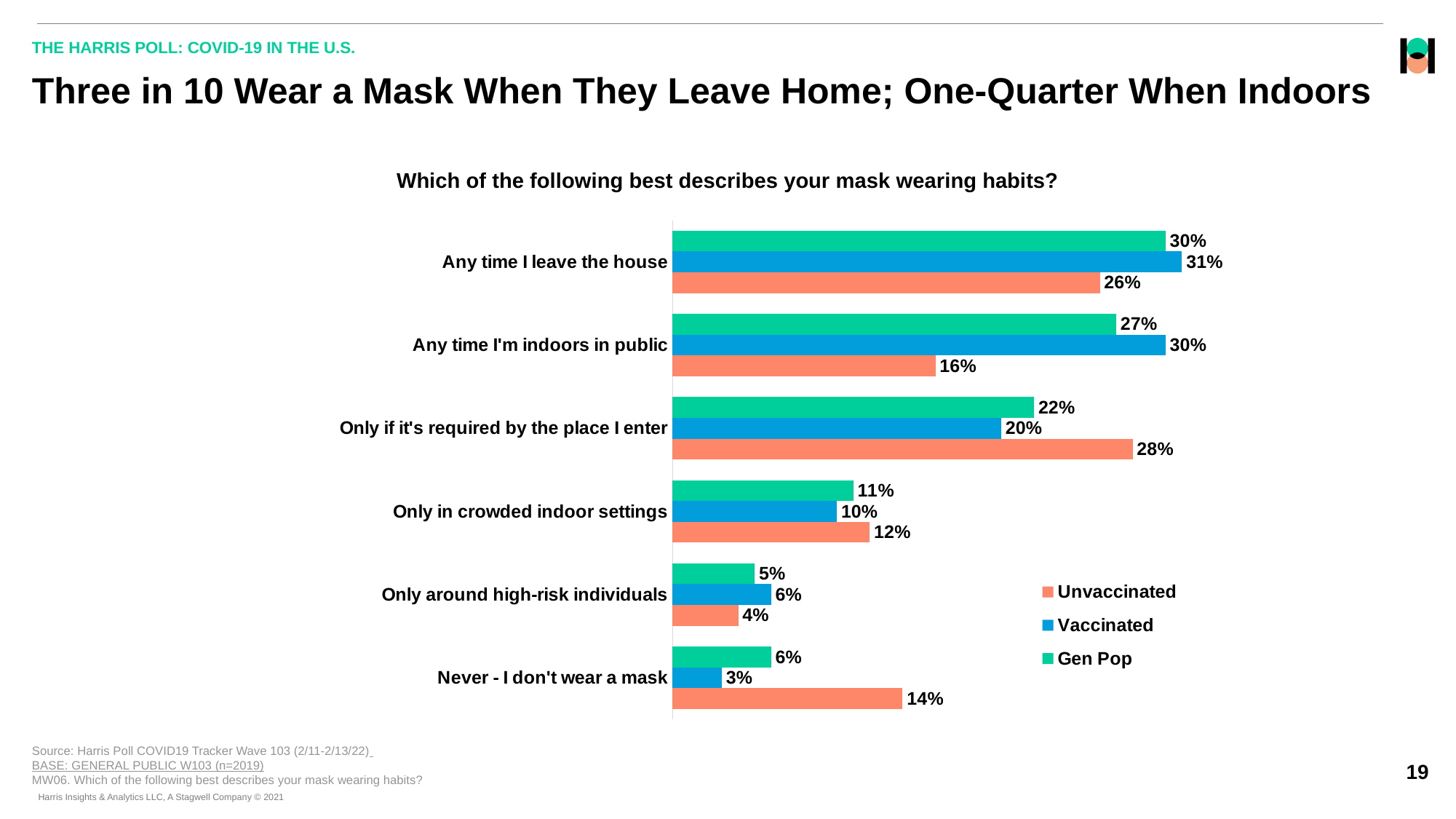
What type of chart is shown on the slide? Bar chart How many series does the legend list? 3 What is the difference between the Gen Pop and Unvaccinated values for 'Any time I'm indoors in public'? 11% What is the Vaccinated value for 'Never - I don't wear a mask'? 3% For 'Any time I'm indoors in public', which is larger: the Vaccinated value or the Unvaccinated value? Vaccinated What percentage of Gen Pop respondents say they wear a mask any time they leave the house? 30% How many response categories are shown on the chart? 6 Which category has the highest Unvaccinated value? Only if it's required by the place I enter What is the difference between the Unvaccinated and Vaccinated values for 'Never - I don't wear a mask'? 11% Which series is shown in orange in the legend? Unvaccinated Which category has the lowest Vaccinated value? Never - I don't wear a mask What is the Unvaccinated value for 'Only if it's required by the place I enter'? 28%